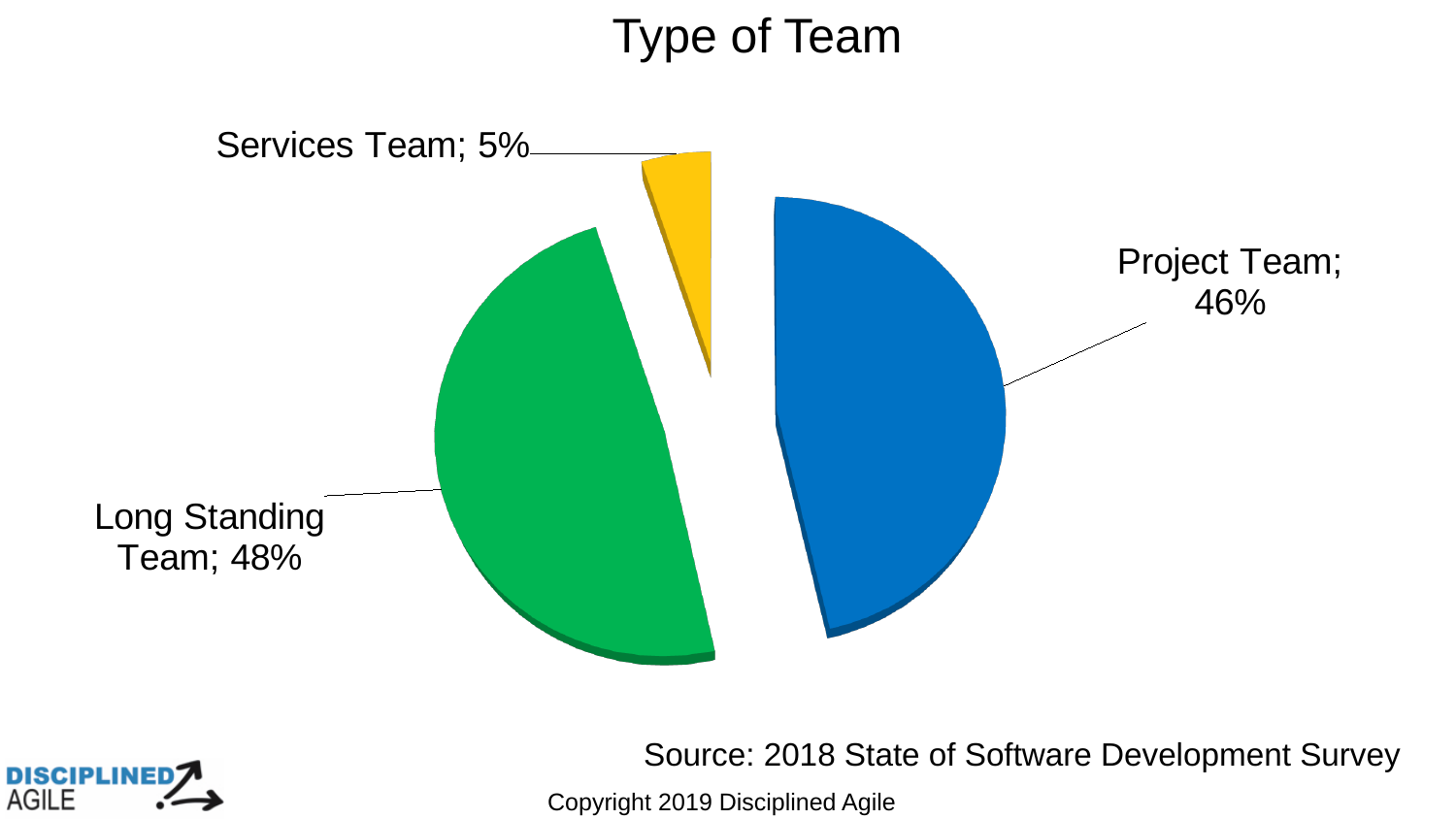
Which type of team has the smallest share? Services Team What is the difference in percentage points between Long Standing Team and Project Team? 2% How many categories are shown in the pie chart? 3 What kind of chart is shown on the slide? Pie chart What share of the pie does Long Standing Team have? 48% What share of the pie does Project Team have? 46% What is the difference in percentage points between Project Team and Services Team? 41% What share of the pie does Services Team have? 5% Which is larger, the share for Project Team or the share for Services Team? Project Team What is the title of the chart? Type of Team Which type of team has the largest share? Long Standing Team What colour is the Services Team slice? Yellow